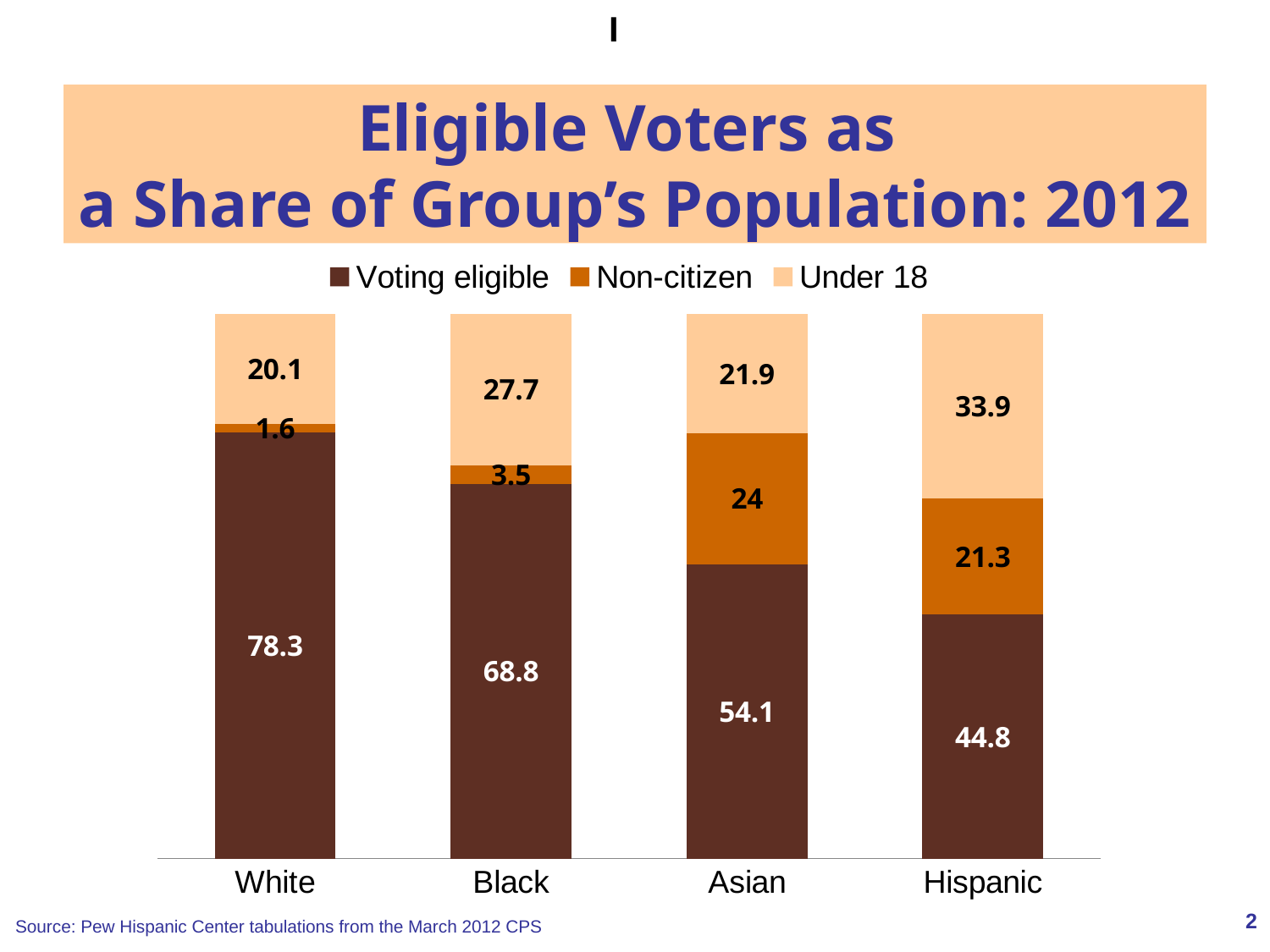
How many groups are shown on the x axis? 4 Which group has the lowest Non-citizen value? White What is the total of the stacked bar for Asian? 100 What is the Non-citizen value for Black? 3.5 What is the Non-citizen value for Asian? 24 Which group has the highest Voting eligible value? White What is the Voting eligible value for White? 78.3 What is the difference between the Voting eligible values for White and Hispanic? 33.5 How many series does the legend list? 3 Which is larger, the Under 18 value for Black or for Asian? Black What kind of chart is shown? Stacked bar chart What is the Under 18 value for Hispanic? 33.9